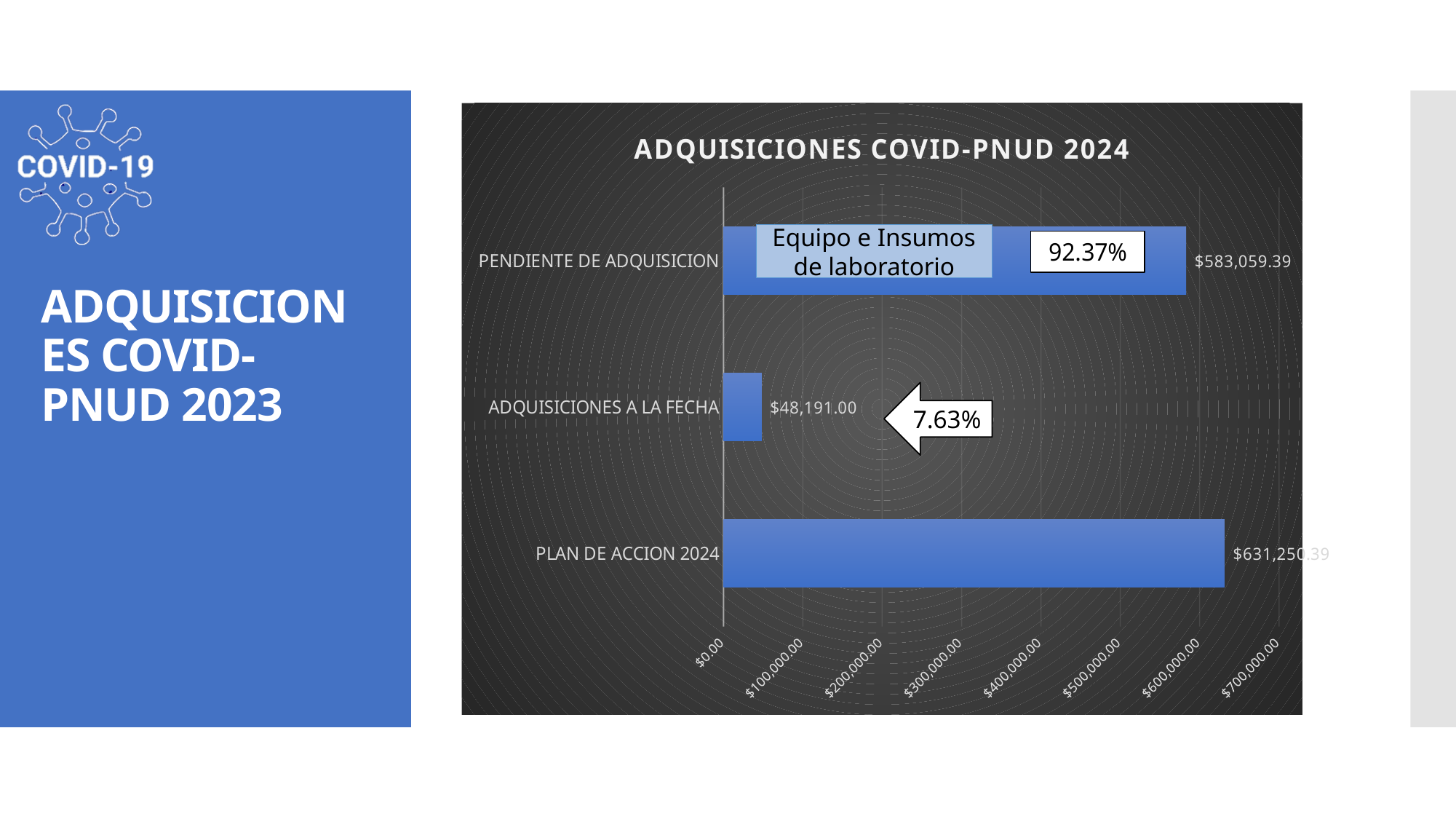
What is the difference between PLAN DE ACCION 2024 and PENDIENTE DE ADQUISICION? $48,191.00 How many categories are shown in the chart? 3 What is the value for PLAN DE ACCION 2024? $631,250.39 What is the value for ADQUISICIONES A LA FECHA? $48,191.00 What is the value for PENDIENTE DE ADQUISICION? $583,059.39 Which category has the lowest value? ADQUISICIONES A LA FECHA Which is larger, PENDIENTE DE ADQUISICION or ADQUISICIONES A LA FECHA? PENDIENTE DE ADQUISICION Is the value for ADQUISICIONES A LA FECHA greater or less than $100,000.00? less What is the difference between PENDIENTE DE ADQUISICION and ADQUISICIONES A LA FECHA? $534,868.39 What kind of chart is shown on the slide? Bar chart What is the title of the chart? ADQUISICIONES COVID-PNUD 2024 Which category has the highest value? PLAN DE ACCION 2024